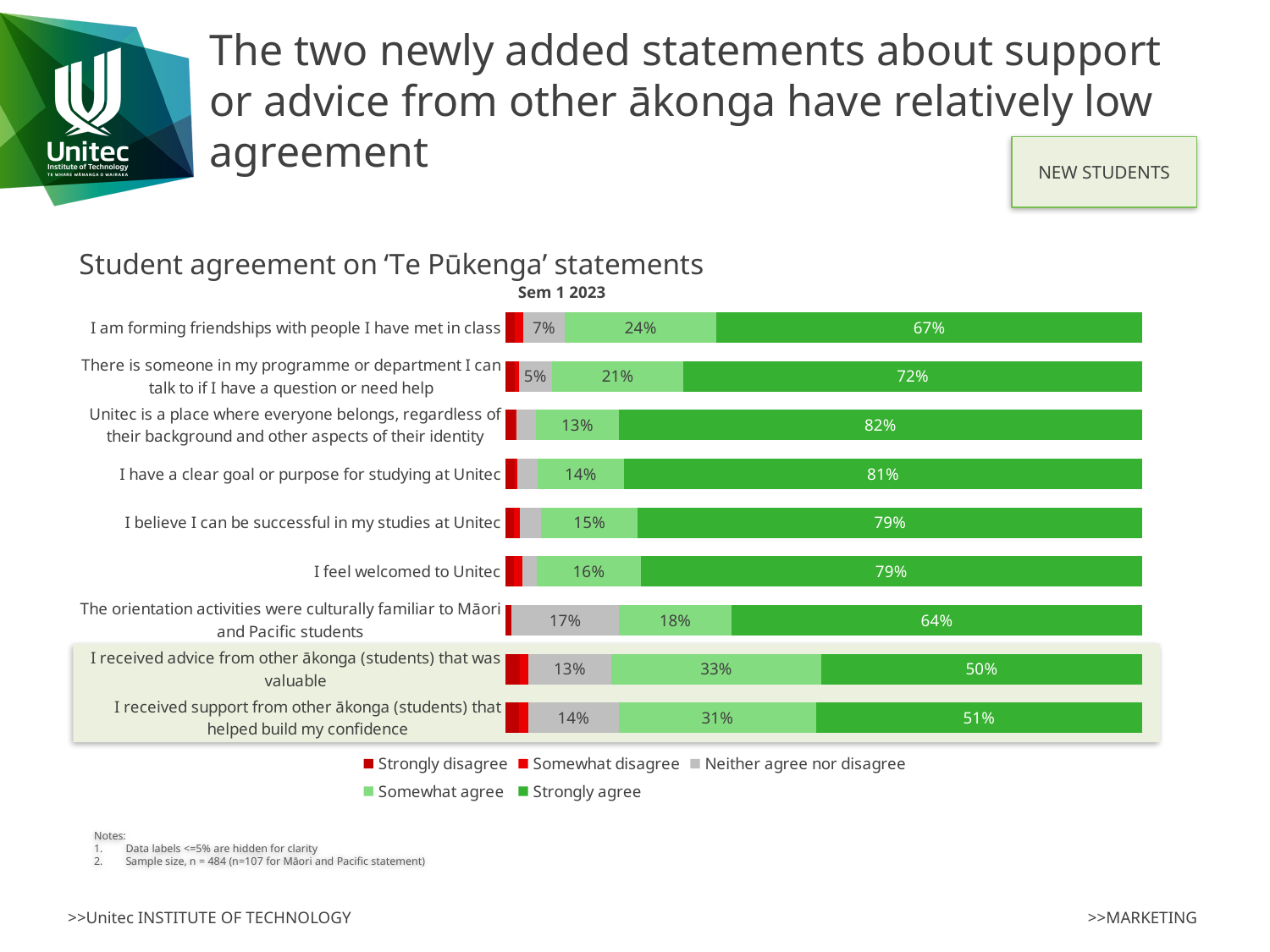
Which statement has a larger 'Strongly agree' share: 'I have a clear goal or purpose for studying at Unitec' or 'I believe I can be successful in my studies at Unitec'? I have a clear goal or purpose for studying at Unitec What percentage of students somewhat agree with the statement 'I received advice from other ākonga (students) that was valuable'? 33% How many percentage points higher is the 'Strongly agree' share for 'There is someone in my programme or department I can talk to if I have a question or need help' than for 'I am forming friendships with people I have met in class'? 5 percentage points What is the 'Neither agree nor disagree' percentage for the statement 'The orientation activities were culturally familiar to Māori and Pacific students'? 17% Which statement has the lowest 'Strongly agree' percentage? I received advice from other ākonga (students) that was valuable What type of chart is shown on the slide? Stacked bar chart How many statements are shown in the chart? 9 What is the difference in 'Somewhat agree' percentages between 'I received advice from other ākonga (students) that was valuable' and 'I received support from other ākonga (students) that helped build my confidence'? 2 percentage points What percentage of new students strongly agree that Unitec is a place where everyone belongs, regardless of their background and other aspects of their identity? 82% What is the title of the chart? Student agreement on 'Te Pūkenga' statements Which statement has the highest 'Strongly agree' percentage? Unitec is a place where everyone belongs, regardless of their background and other aspects of their identity How many response categories does the legend list? 5